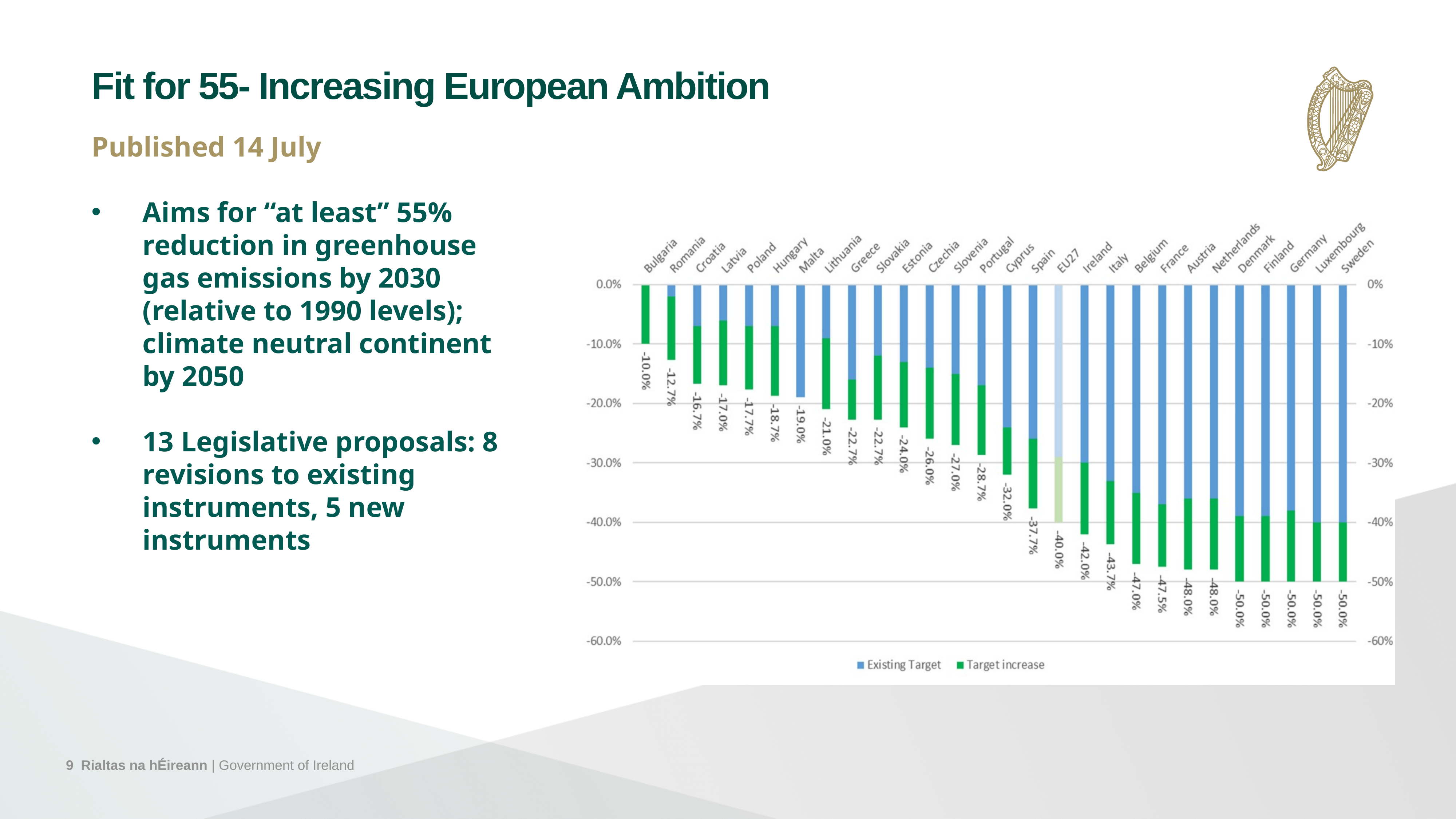
What are the two series named in the chart legend? Existing Target and Target increase What is the total labelled value for EU27 in the chart? -40.0% What is the difference between the labelled totals for Spain (-37.7%) and Portugal (-28.7%)? 9.0 percentage points What is the total labelled value for Bulgaria in the chart? -10.0% Which has the larger reduction in the chart, Italy or Belgium? Belgium Do the labelled totals become more negative or less negative moving from left to right along the x axis? More negative How many countries have a labelled total of -50.0% in the chart? 5 Which country has the smallest total reduction (the value closest to 0%) in the chart? Bulgaria How many countries/categories are plotted on the x axis of the chart? 28 What is the total labelled value for Ireland in the chart? -42.0% How many series does the chart legend list? 2 What kind of chart is shown on the slide? Stacked bar chart